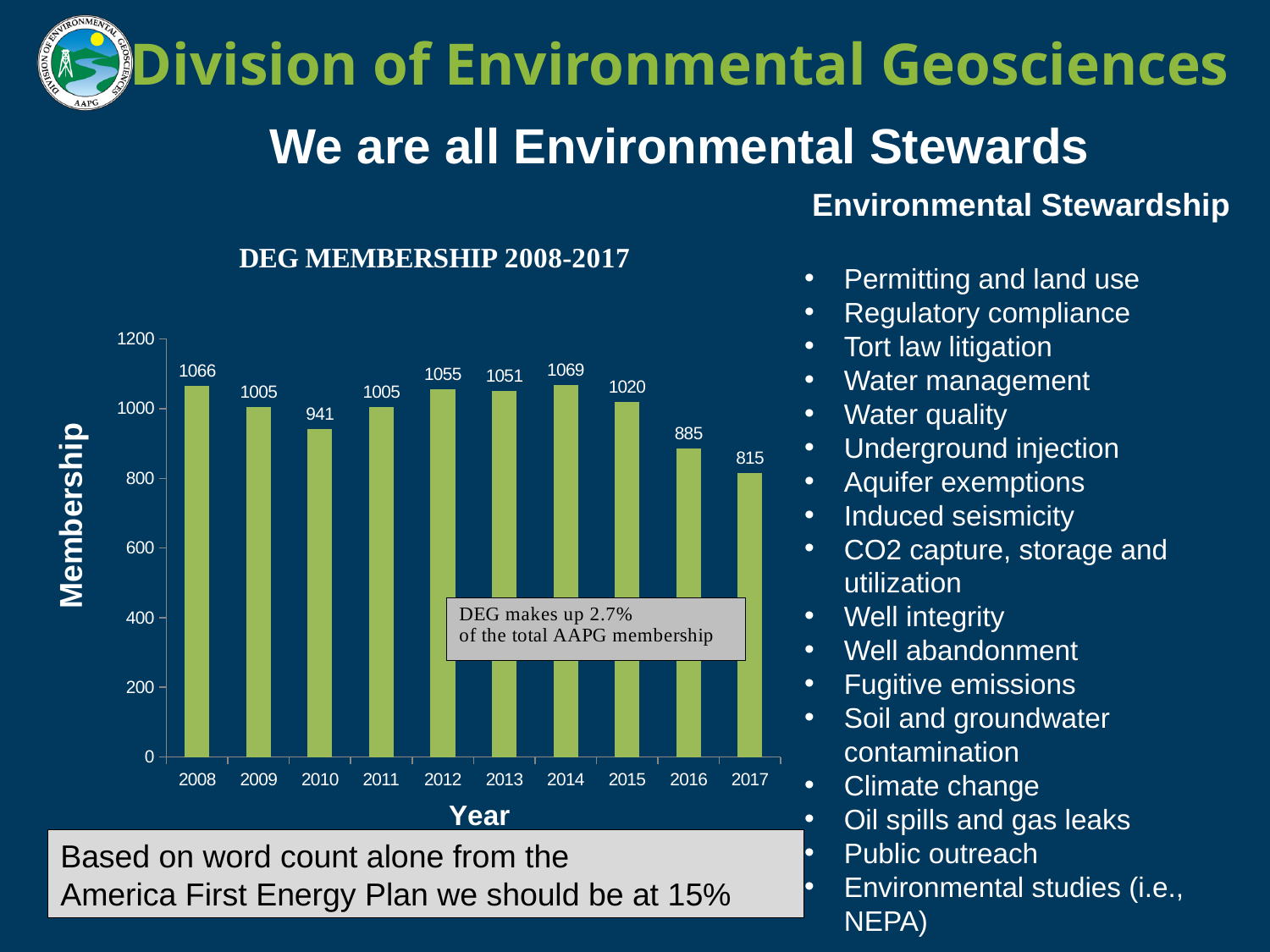
What was the DEG membership in 2008? 1066 What is the title of the chart? DEG MEMBERSHIP 2008-2017 How many years are shown on the x axis of the chart? 10 What is the label of the y axis of the chart? Membership Which year had higher membership, 2012 or 2016? 2012 Does DEG membership rise or fall from 2014 to 2017? Fall Which year had the highest DEG membership? 2014 What is the difference in membership between 2008 and 2017? 251 Which year had the lowest DEG membership? 2017 What was the DEG membership in 2010? 941 What kind of chart is used to show DEG membership? Bar chart What was the DEG membership in 2017? 815